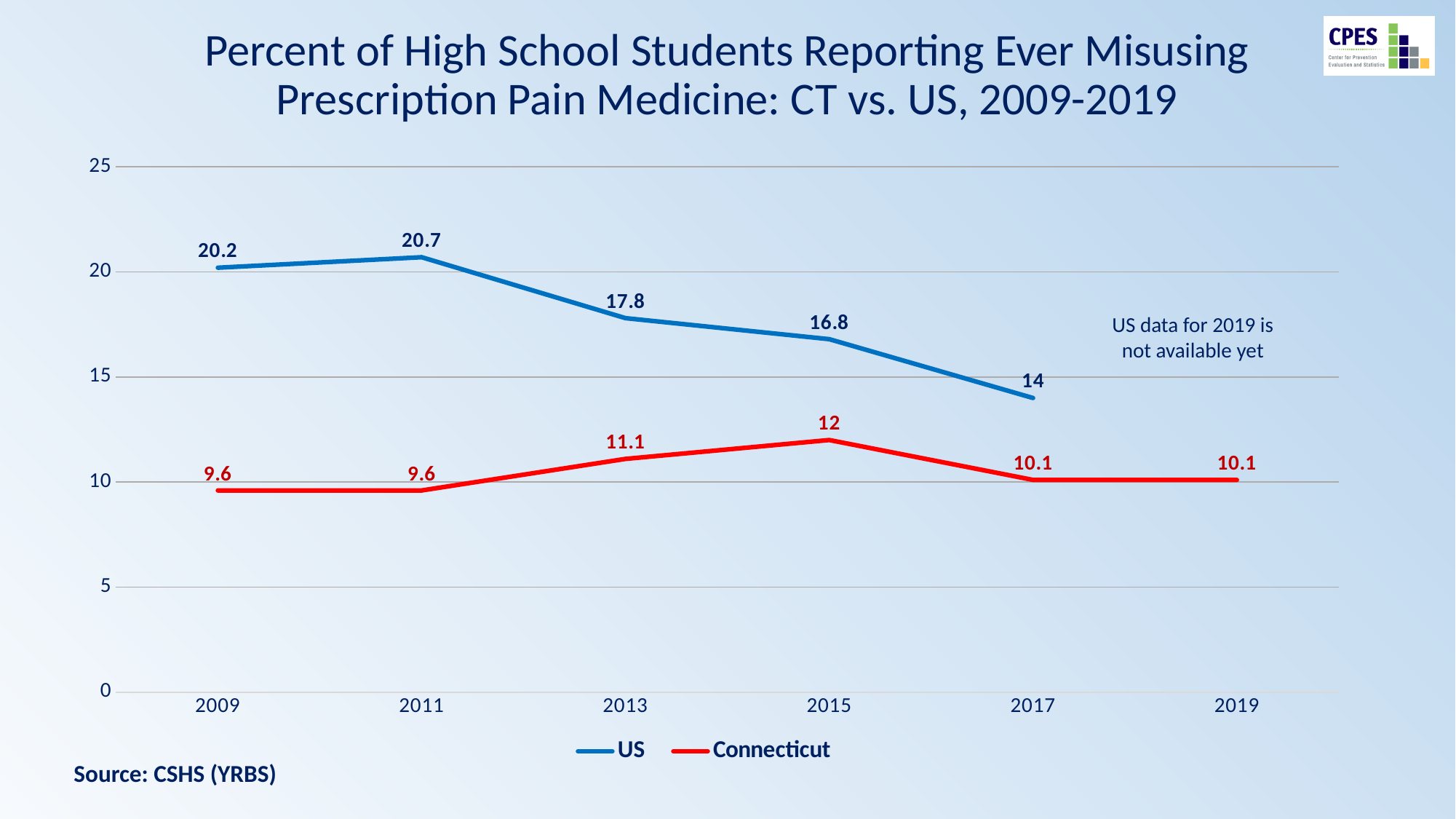
What is the difference between the US values for 2011 and 2017? 6.7 In which year is the Connecticut series highest? 2015 How many years are shown on the x axis? 6 What is the difference between the US and Connecticut values in 2009? 10.6 What kind of chart is shown on the slide? Line chart Does the US series rise or fall from 2011 to 2017? Fall How many series does the legend list? 2 What is the US value for 2017? 14 What is the US value for 2011? 20.7 Which series has the larger value in 2013, US or Connecticut? US What is the Connecticut value for 2015? 12 In which year is the US series highest? 2011